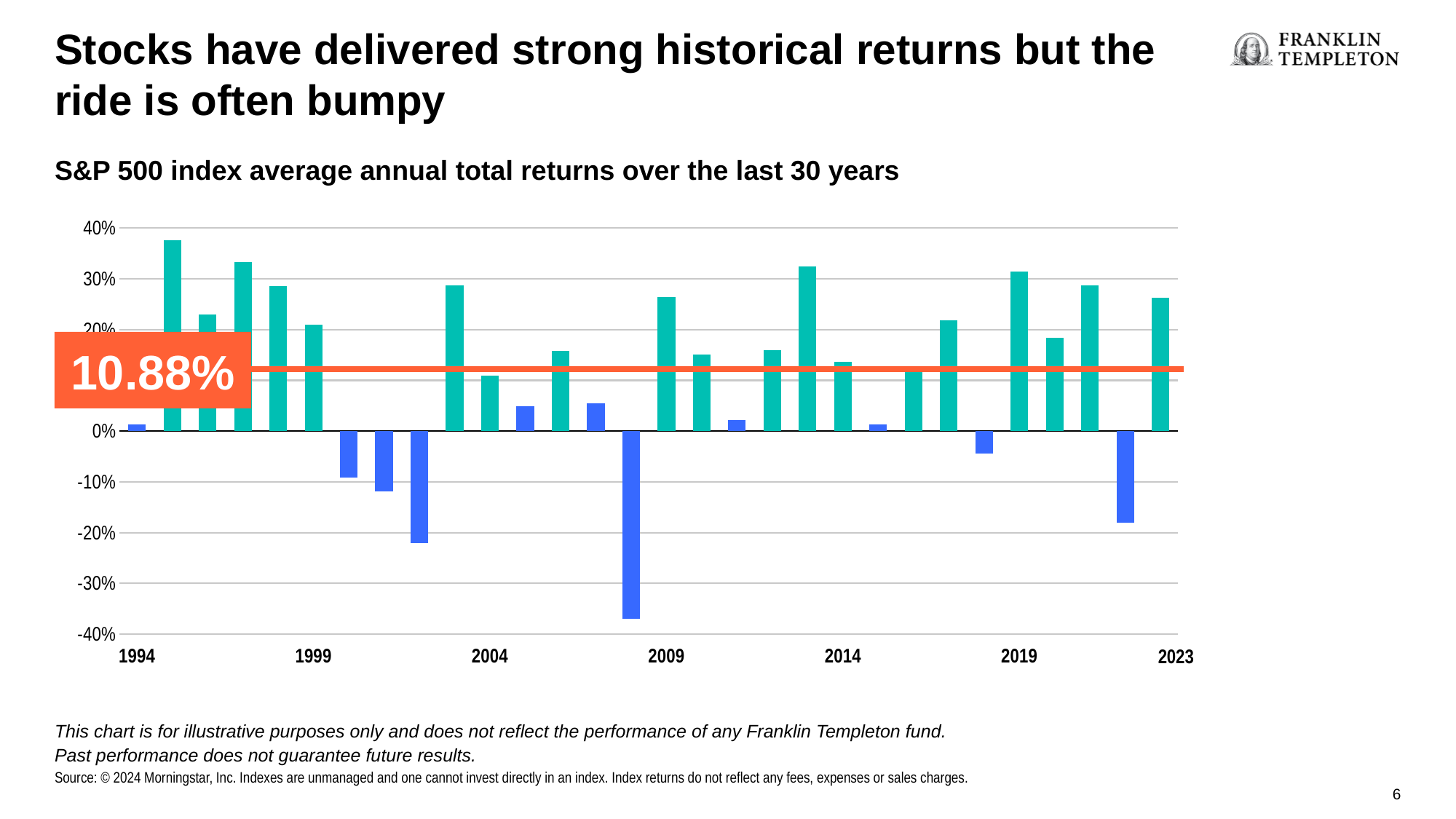
Is the value for 2023 greater or less than 20%? greater Is the value for 1999 greater or less than 20%? greater What value is printed in the orange box on the chart? 10.88% How many bars (years) are plotted in the chart? 30 Is the value for 2014 greater or less than 10%? greater How many bars in the chart are blue (negative returns)? 6 Which year has the larger value, 2014 or 2019? 2019 What kind of chart is shown on the slide? bar chart